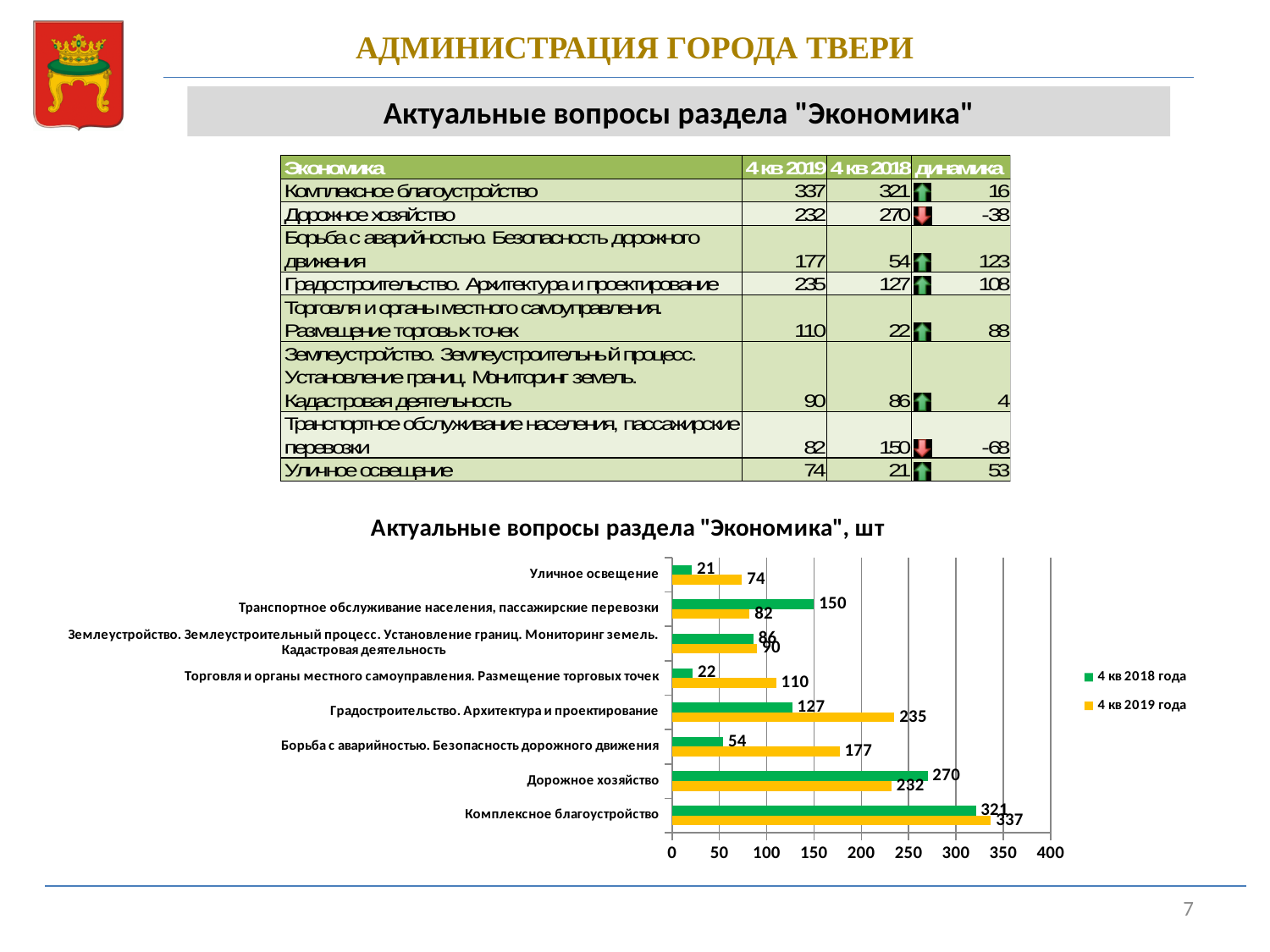
Which category has the highest value in the 4 кв 2019 года series? Комплексное благоустройство How many categories are plotted in the chart? 8 What is the value for Дорожное хозяйство in the 4 кв 2018 года series? 270 Which colour represents the 4 кв 2019 года series in the chart? yellow What kind of chart is shown on the slide? bar chart Which category has the lowest value in the 4 кв 2018 года series? Уличное освещение What is the value for Уличное освещение in the 4 кв 2019 года series? 74 What is the difference between the 4 кв 2019 года and 4 кв 2018 года values for Борьба с аварийностью. Безопасность дорожного движения? 123 For Транспортное обслуживание населения, пассажирские перевозки, which series has the larger value: 4 кв 2018 года or 4 кв 2019 года? 4 кв 2018 года What is the value for Комплексное благоустройство in the 4 кв 2019 года series? 337 How many series does the chart legend list? 2 What is the difference between the 4 кв 2019 года and 4 кв 2018 года values for Градостроительство. Архитектура и проектирование? 108